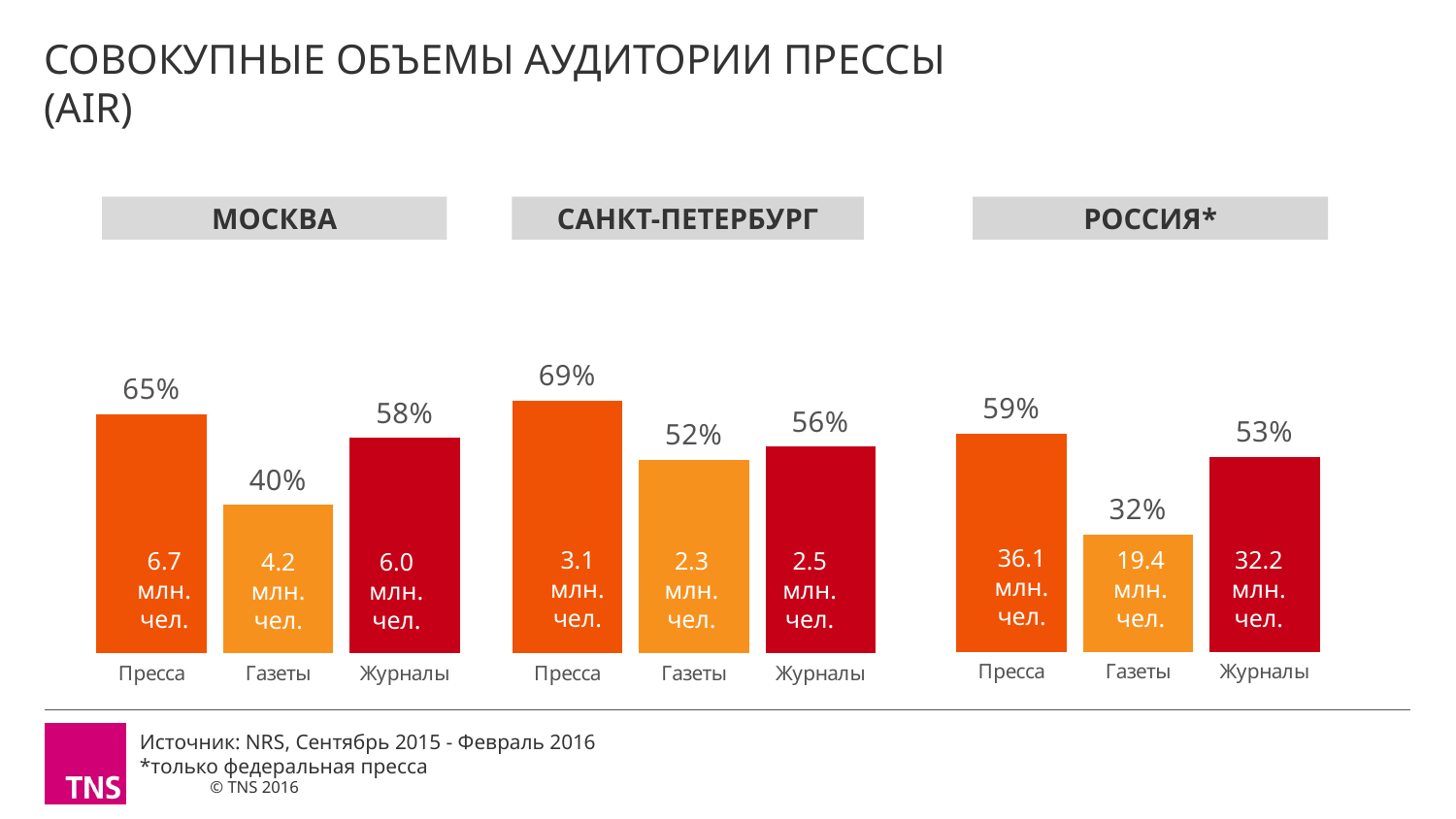
In the Санкт-Петербург chart, what is the difference in million people between Пресса and Газеты? 0.8 млн. чел. In the Москва chart, how many million people are shown for Газеты? 4.2 млн. чел. What type of chart is used for Москва? Bar chart How many bars are in the Санкт-Петербург chart? 3 In the Санкт-Петербург chart, what percentage is shown for Журналы? 56% In the Россия* chart, how many million people are shown for Пресса? 36.1 млн. чел. In the Россия* chart, which is larger, the percentage for Журналы or for Газеты? Журналы What colour is the Журналы bar in each chart? Red In the Санкт-Петербург chart, which category has the highest percentage? Пресса In the Москва chart, what is the difference in percentage points between Пресса and Газеты? 25 In the Россия* chart, which category has the lowest percentage? Газеты In the Москва chart, what percentage is shown for Пресса? 65%